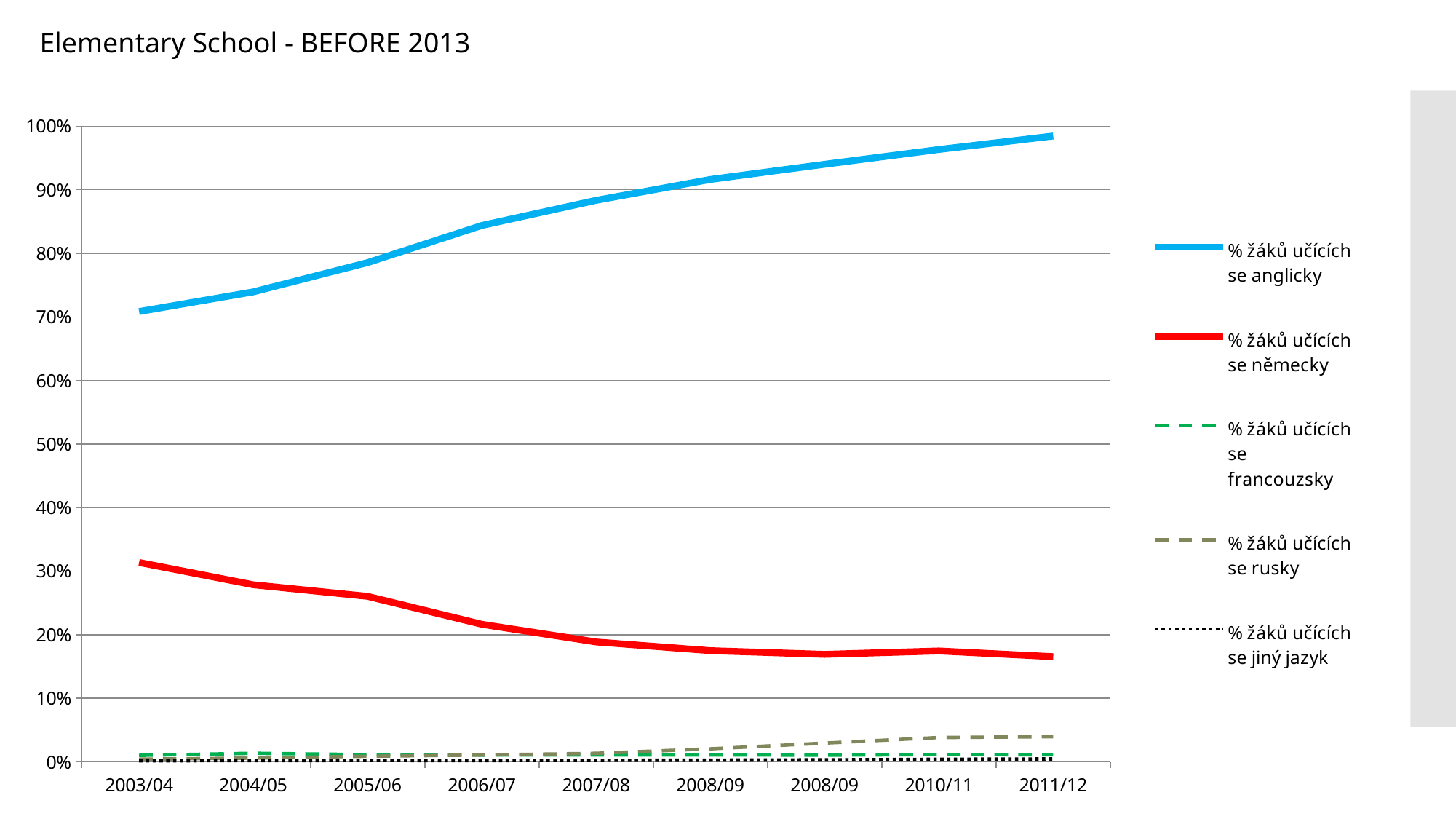
Which series has the highest value in 2011/12? % žáků učících se anglicky Is the value for '% žáků učících se anglicky' in 2011/12 greater or less than 90%? greater How many school-year categories are shown on the x axis? 9 Is the value for '% žáků učících se německy' in 2011/12 greater or less than 20%? less Is the value for '% žáků učících se německy' in 2003/04 greater or less than 40%? less What kind of chart is shown on the slide? line chart Does the value for '% žáků učících se německy' rise or fall from 2003/04 to 2011/12? fall How many series does the legend list? 5 In 2007/08, which is larger: '% žáků učících se anglicky' or '% žáků učících se německy'? % žáků učících se anglicky Does the value for '% žáků učících se anglicky' rise or fall from 2003/04 to 2011/12? rise What is the title of the chart? Elementary School - BEFORE 2013